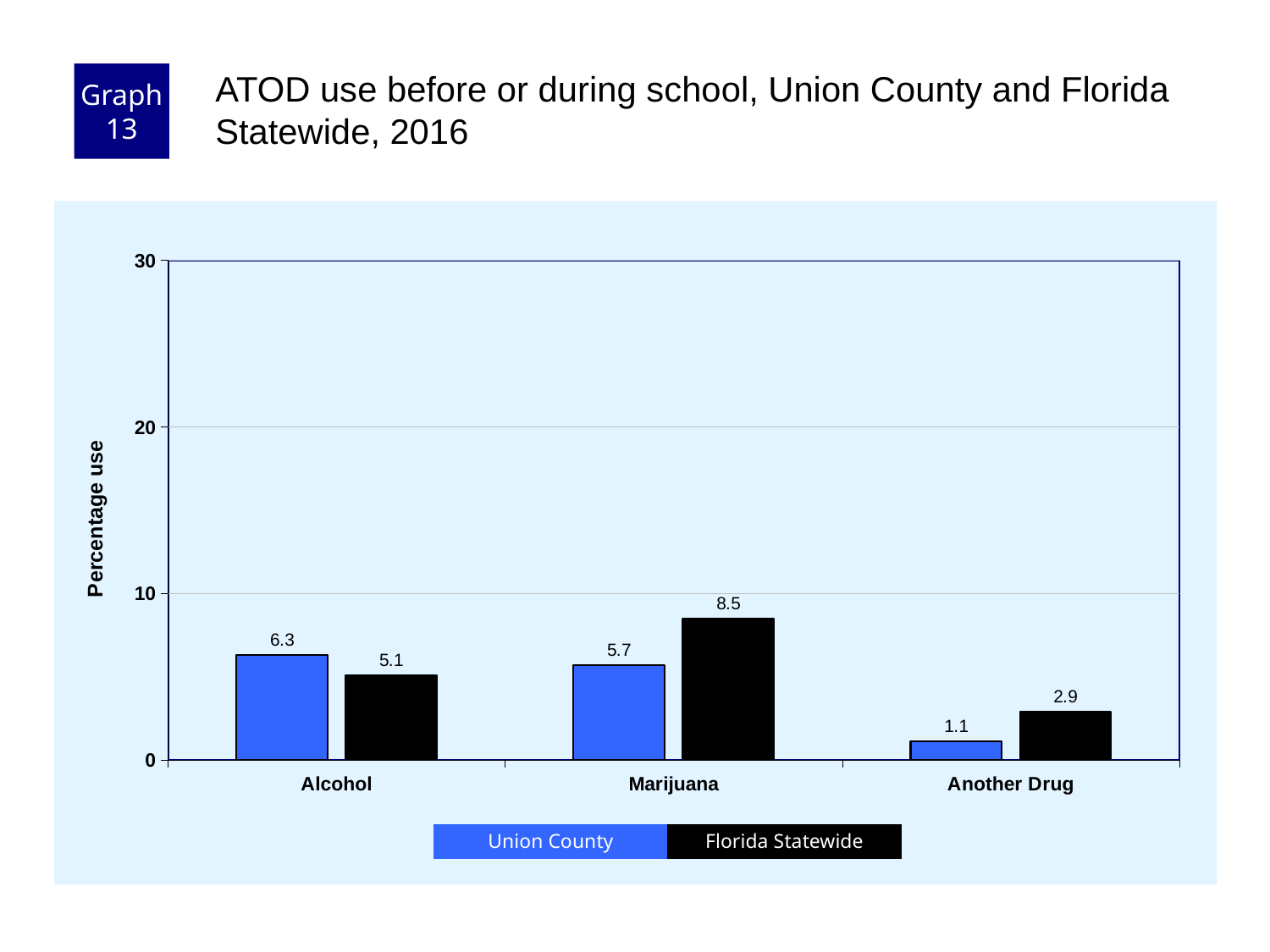
What kind of chart is shown on the slide? bar chart Which category has the highest Florida Statewide value? Marijuana Is the Florida Statewide value for Marijuana greater or less than 10? less For Alcohol, which is larger: Union County or Florida Statewide? Union County What is the Florida Statewide value for Marijuana? 8.5 Which category has the lowest Union County value? Another Drug What is the Union County value for Alcohol? 6.3 How many categories are shown on the x axis? 3 What is the difference between the Florida Statewide and Union County values for Marijuana? 2.8 What is the Florida Statewide value for Alcohol? 5.1 How many series does the legend list? 2 What is the Union County value for Another Drug? 1.1